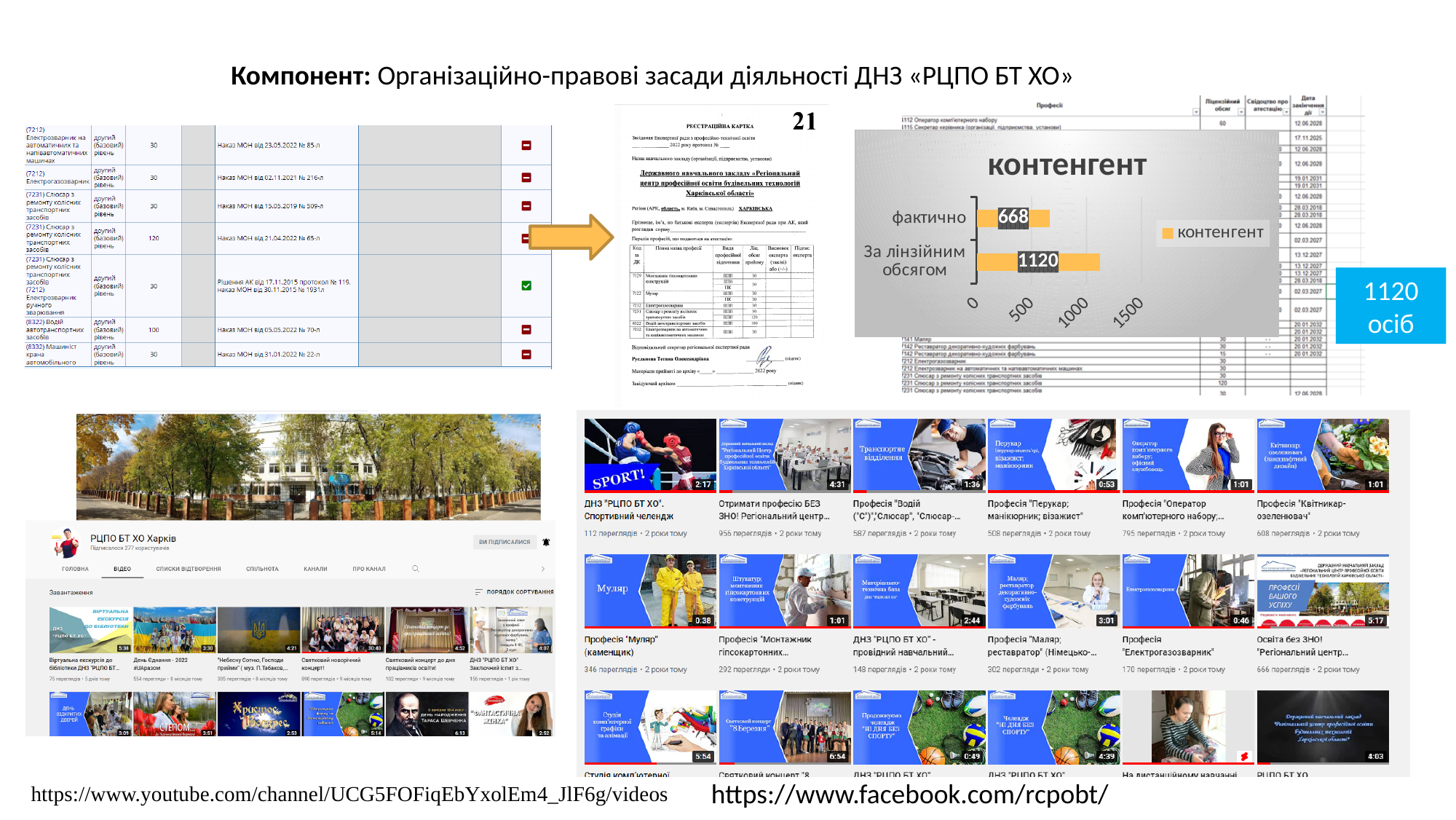
Is the value for "фактично" greater or less than 1000? less What is the difference between the value for "За лінзійним обсягом" and the value for "фактично"? 452 Which is larger: the value for "фактично" or the value for "За лінзійним обсягом"? За лінзійним обсягом How many series does the chart legend list? 1 What is the title of the chart on the slide? контенгент What is the value for "фактично" in the chart? 668 Which category has the highest value in the chart? За лінзійним обсягом Which category has the lowest value in the chart? фактично Is the value for "За лінзійним обсягом" greater or less than 1000? greater How many categories are shown in the chart? 2 What type of chart is shown on the slide? bar chart What is the value for "За лінзійним обсягом" in the chart? 1120